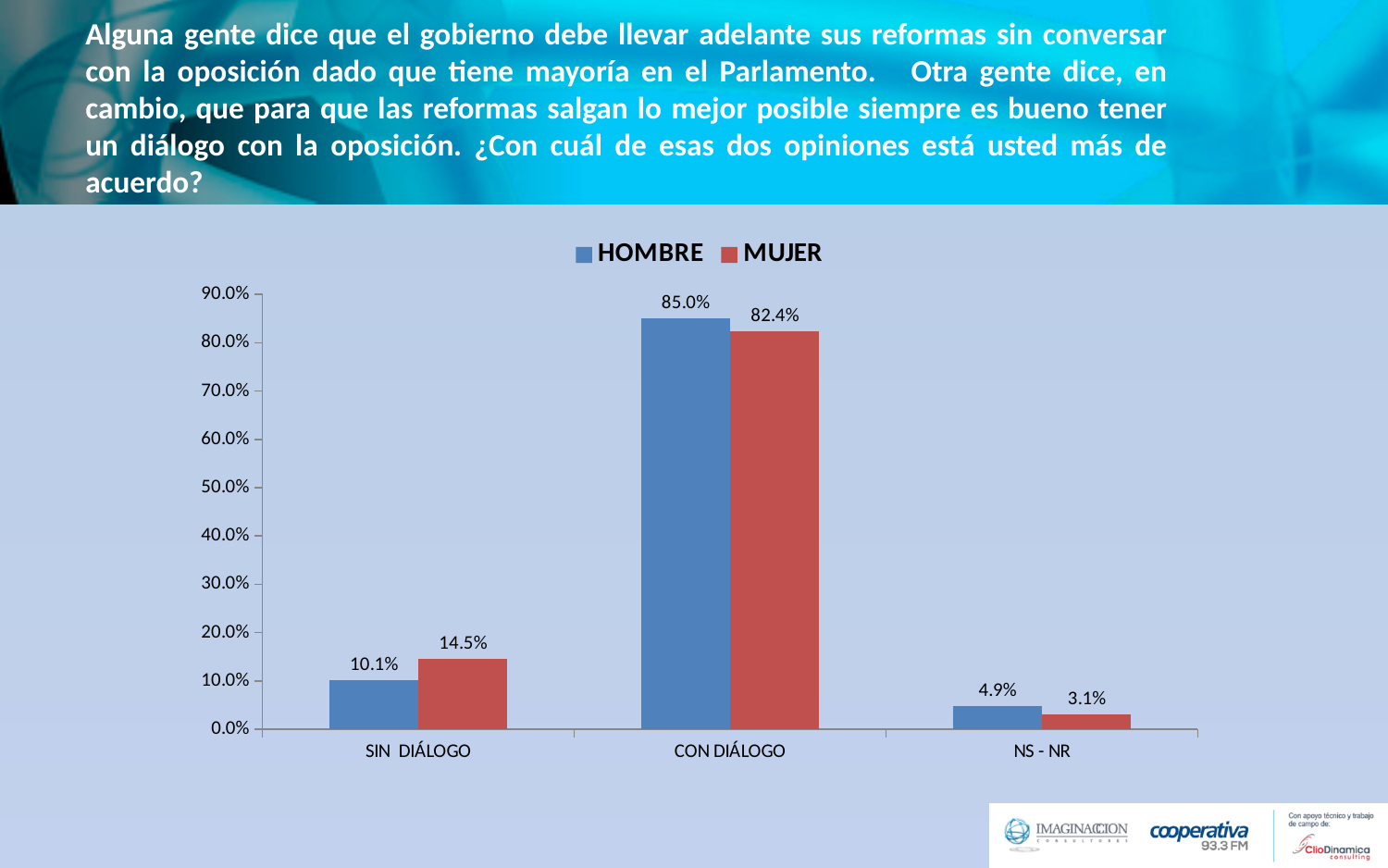
How many series does the legend list? 2 Is the HOMBRE value for CON DIÁLOGO greater or less than 80.0%? greater Which category has the lowest value for the MUJER series? NS - NR What is the difference between the HOMBRE and MUJER values in the CON DIÁLOGO category? 2.6% What is the value for MUJER in the CON DIÁLOGO category? 82.4% In the SIN DIÁLOGO category, which series has the larger value, HOMBRE or MUJER? MUJER What kind of chart is shown on the slide? bar chart Which category has the highest value for the HOMBRE series? CON DIÁLOGO What is the value for MUJER in the SIN DIÁLOGO category? 14.5% What is the value for HOMBRE in the NS - NR category? 4.9% What is the value for HOMBRE in the SIN DIÁLOGO category? 10.1% How many categories are shown on the x axis? 3